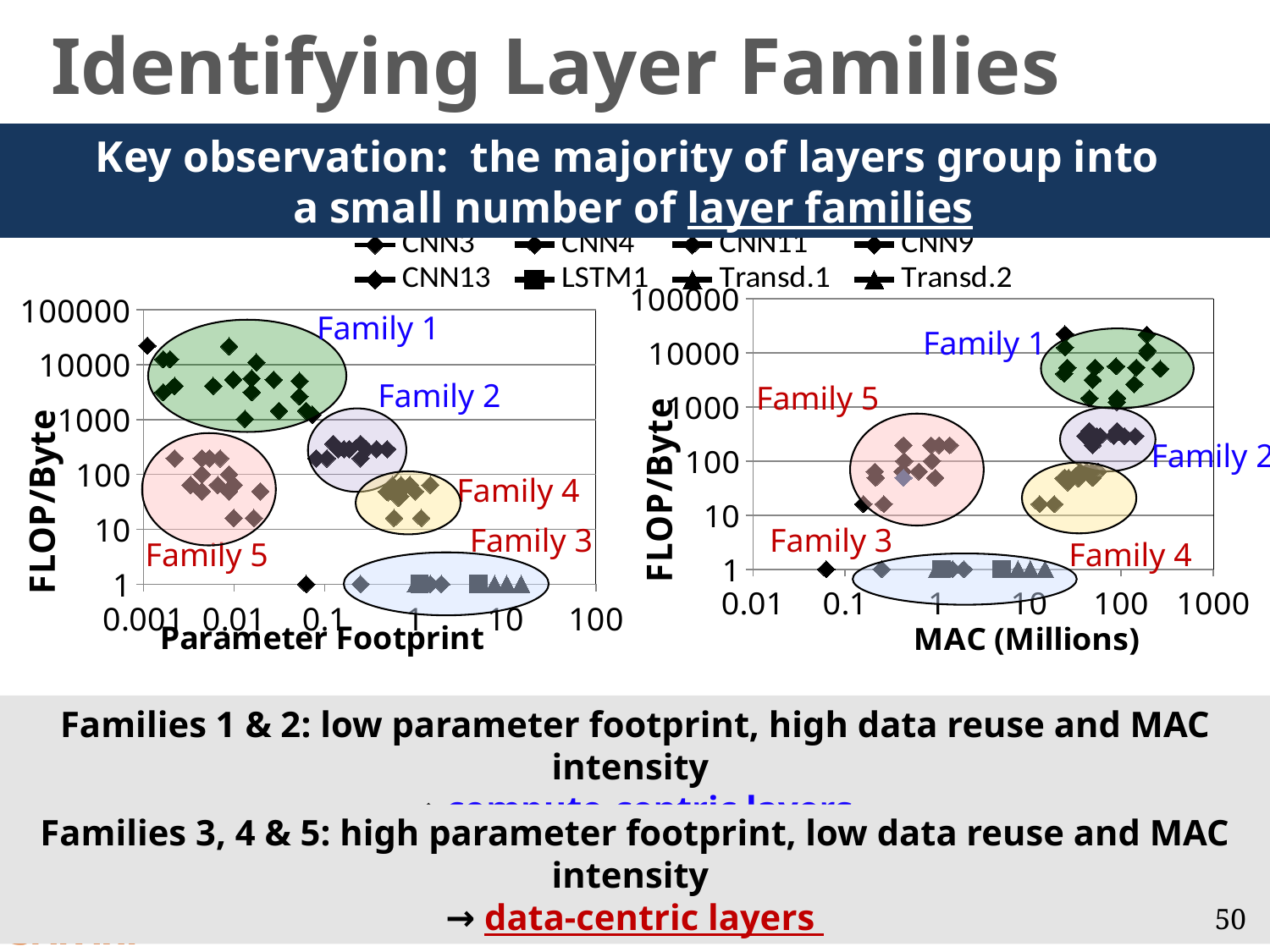
What kind of chart is the right chart (FLOP/Byte vs MAC (Millions))? scatter chart What is the x-axis label of the left chart? Parameter Footprint On the right chart, are the FLOP/Byte values of the Family 1 points greater or less than 1000? greater On the left chart, are the FLOP/Byte values of the Family 3 points greater or less than 10? less What is the x-axis label of the right chart? MAC (Millions) On the left chart, which family has higher FLOP/Byte values, Family 1 or Family 3? Family 1 What kind of chart is the left chart (FLOP/Byte vs Parameter Footprint)? scatter chart How many layer families are annotated on the left chart? 5 How many series does the shared legend list for the charts? 8 On the left chart, are the FLOP/Byte values of the Family 2 points greater or less than 100? greater